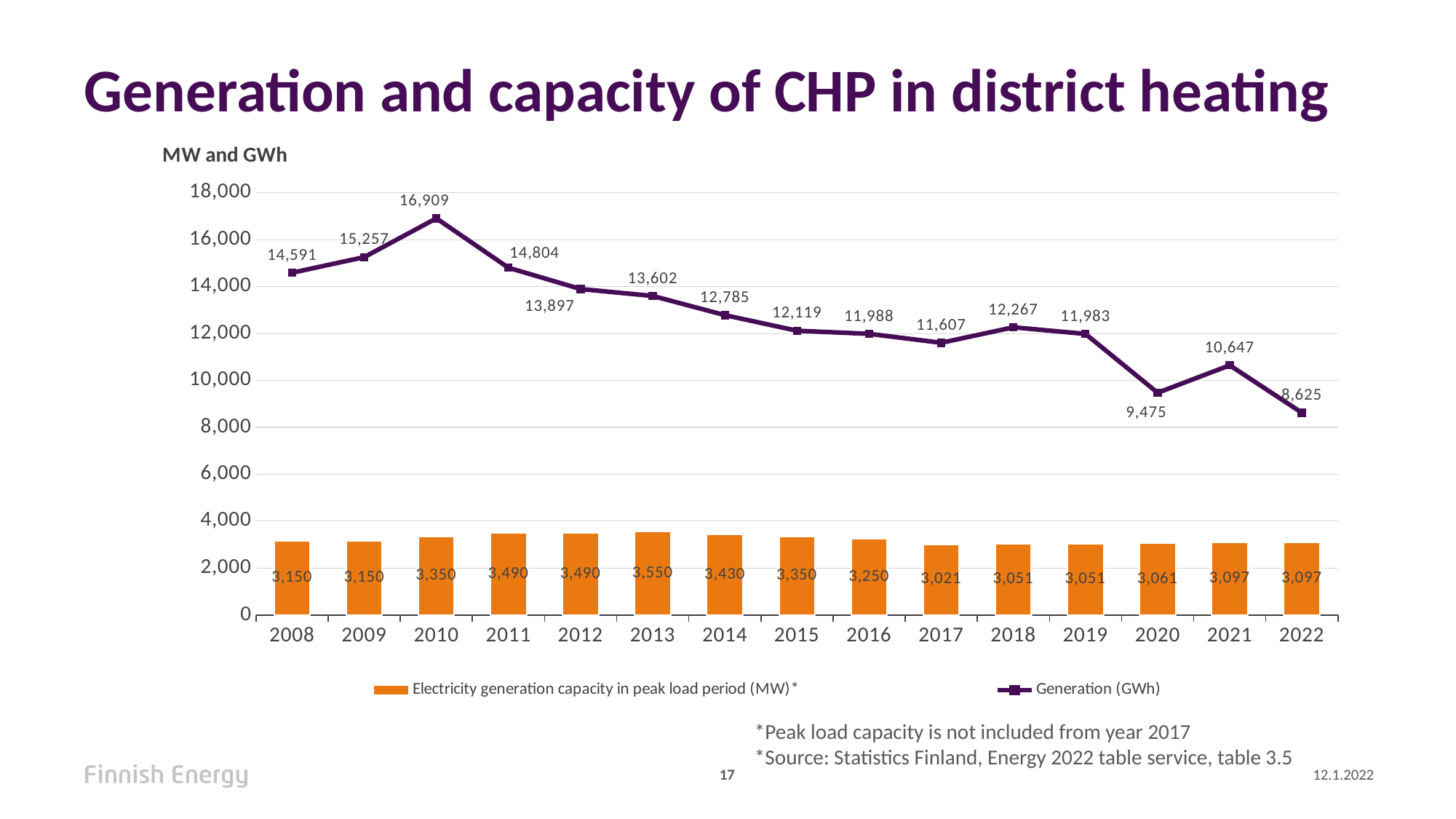
In which year is the Electricity generation capacity in peak load period (MW) highest? 2013 By how much did Generation (GWh) fall from 2021 to 2022? 2,022 What is the Generation (GWh) value for 2010? 16,909 How many series does the legend list? 2 What is the difference in Electricity generation capacity in peak load period (MW) between 2011 and 2008? 340 Which year has the higher Generation (GWh), 2018 or 2019? 2018 In which year is Generation (GWh) lowest? 2022 What kind of chart is shown on the slide? Combined bar and line chart How many years are shown on the x axis? 15 In which year is Generation (GWh) highest? 2010 What is the Electricity generation capacity in peak load period (MW) for 2013? 3,550 Does Generation (GWh) generally rise or fall from 2010 to 2022? Fall